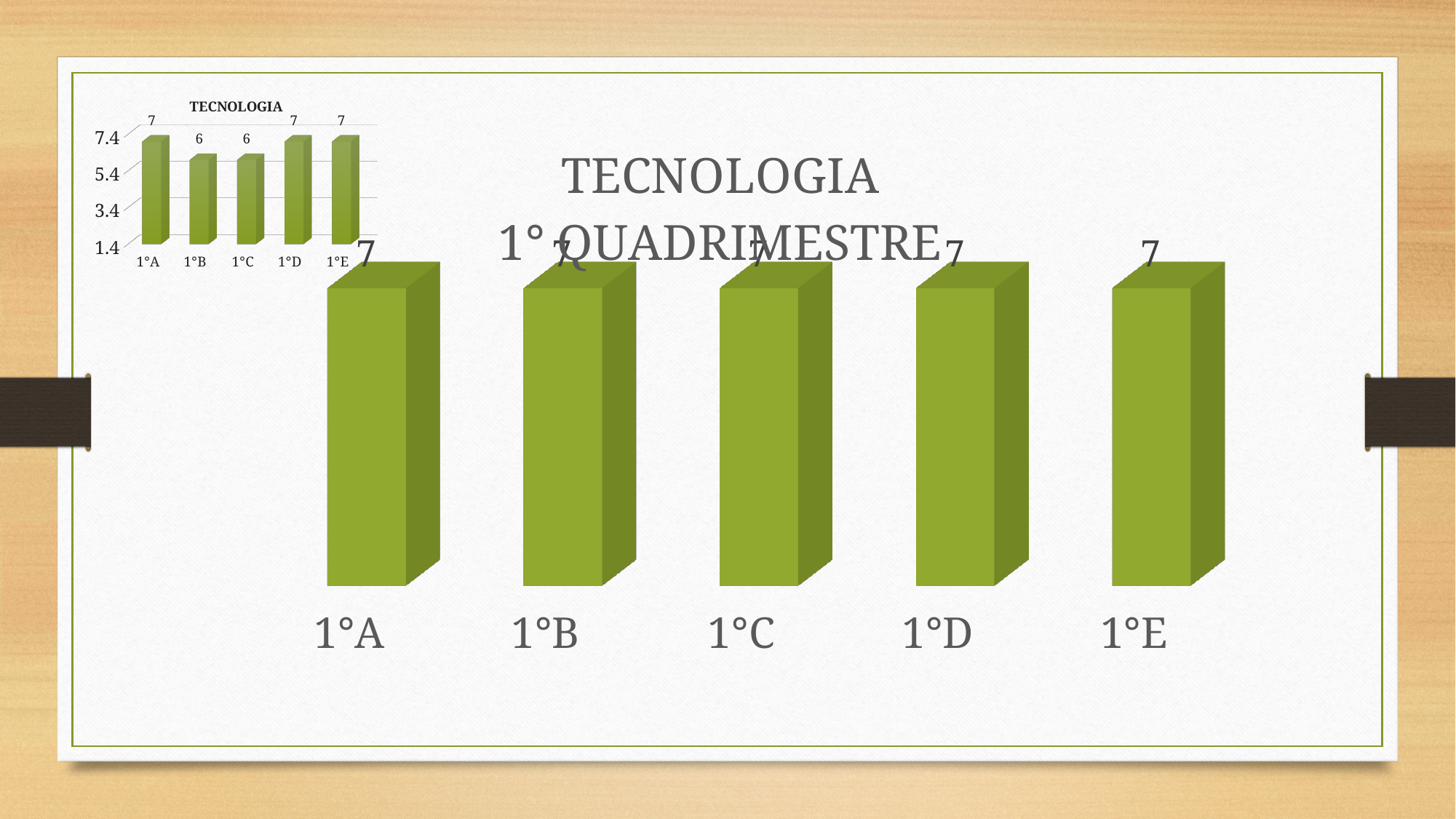
In the small chart at the top left titled TECNOLOGIA, how many categories are shown? 5 What kind of chart is the large chart titled TECNOLOGIA 1° QUADRIMESTRE? Bar chart In the large chart titled TECNOLOGIA 1° QUADRIMESTRE, what is the value for 1°C? 7 In the small chart at the top left titled TECNOLOGIA, what is the value for 1°D? 7 In the small chart at the top left titled TECNOLOGIA, which is larger, the value for 1°C or the value for 1°E? 1°E In the small chart at the top left titled TECNOLOGIA, which categories have the lowest value? 1°B and 1°C In the large chart titled TECNOLOGIA 1° QUADRIMESTRE, do the values rise, fall or stay the same from 1°A to 1°E? Stay the same What is the title of the small chart at the top left of the slide? TECNOLOGIA In the large chart titled TECNOLOGIA 1° QUADRIMESTRE, how many categories are shown? 5 In the small chart at the top left titled TECNOLOGIA, what is the difference between the values for 1°A and 1°B? 1 In the large chart titled TECNOLOGIA 1° QUADRIMESTRE, what is the value for 1°E? 7 In the small chart at the top left titled TECNOLOGIA, what is the value for 1°B? 6